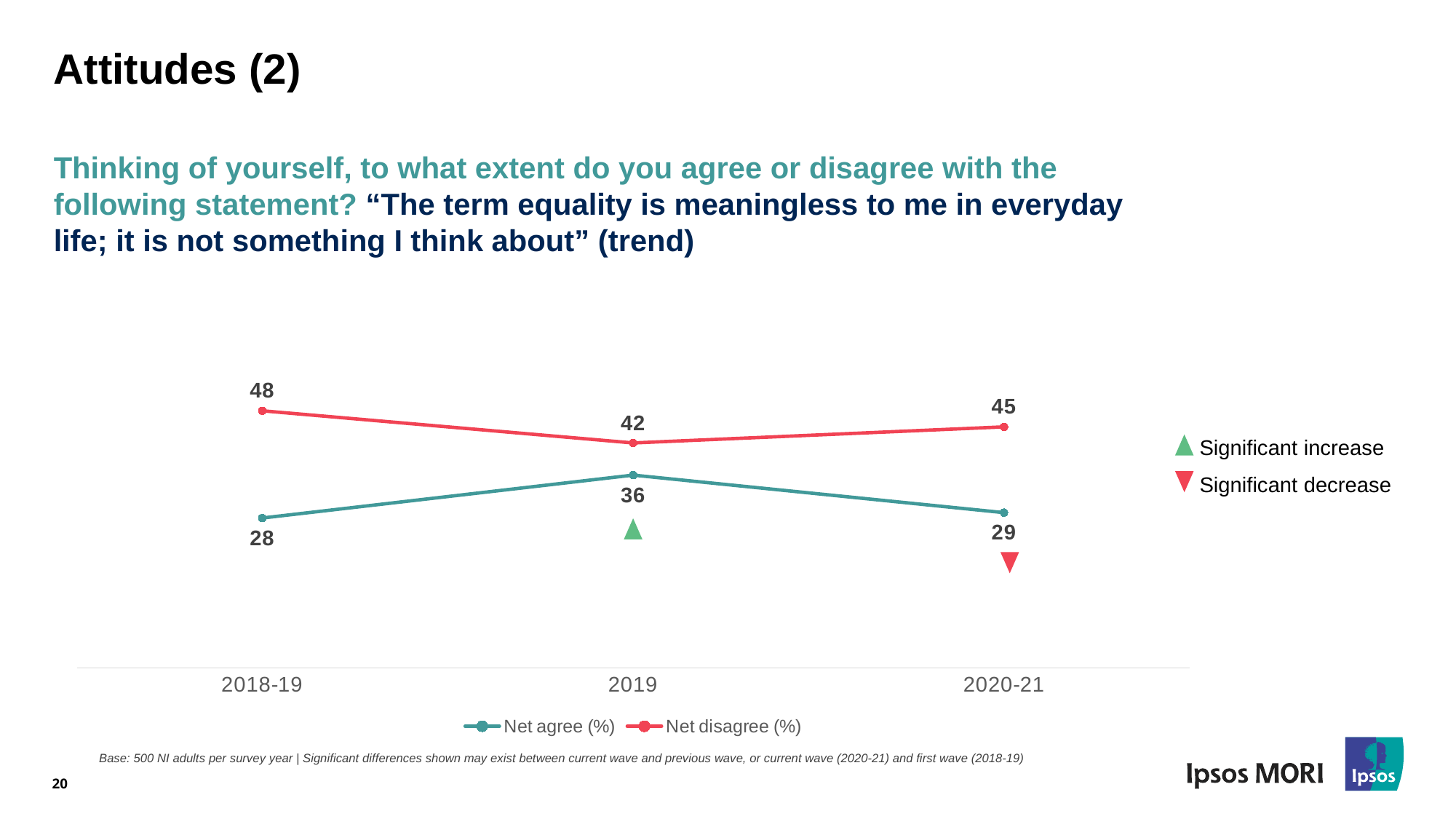
In which year is Net agree (%) lowest? 2018-19 How many survey years are plotted on the x axis? 3 What is the difference between Net disagree (%) and Net agree (%) in 2020-21? 16 Which is larger in 2019, Net agree (%) or Net disagree (%)? Net disagree (%) What is the Net disagree (%) value for 2020-21? 45 In which year is Net disagree (%) highest? 2018-19 What is the Net agree (%) value for 2018-19? 28 What is the Net disagree (%) value for 2019? 42 What is the Net agree (%) value for 2019? 36 Does Net agree (%) rise or fall from 2019 to 2020-21? Fall What kind of chart is shown on the slide? Line chart How many series does the legend list? 2